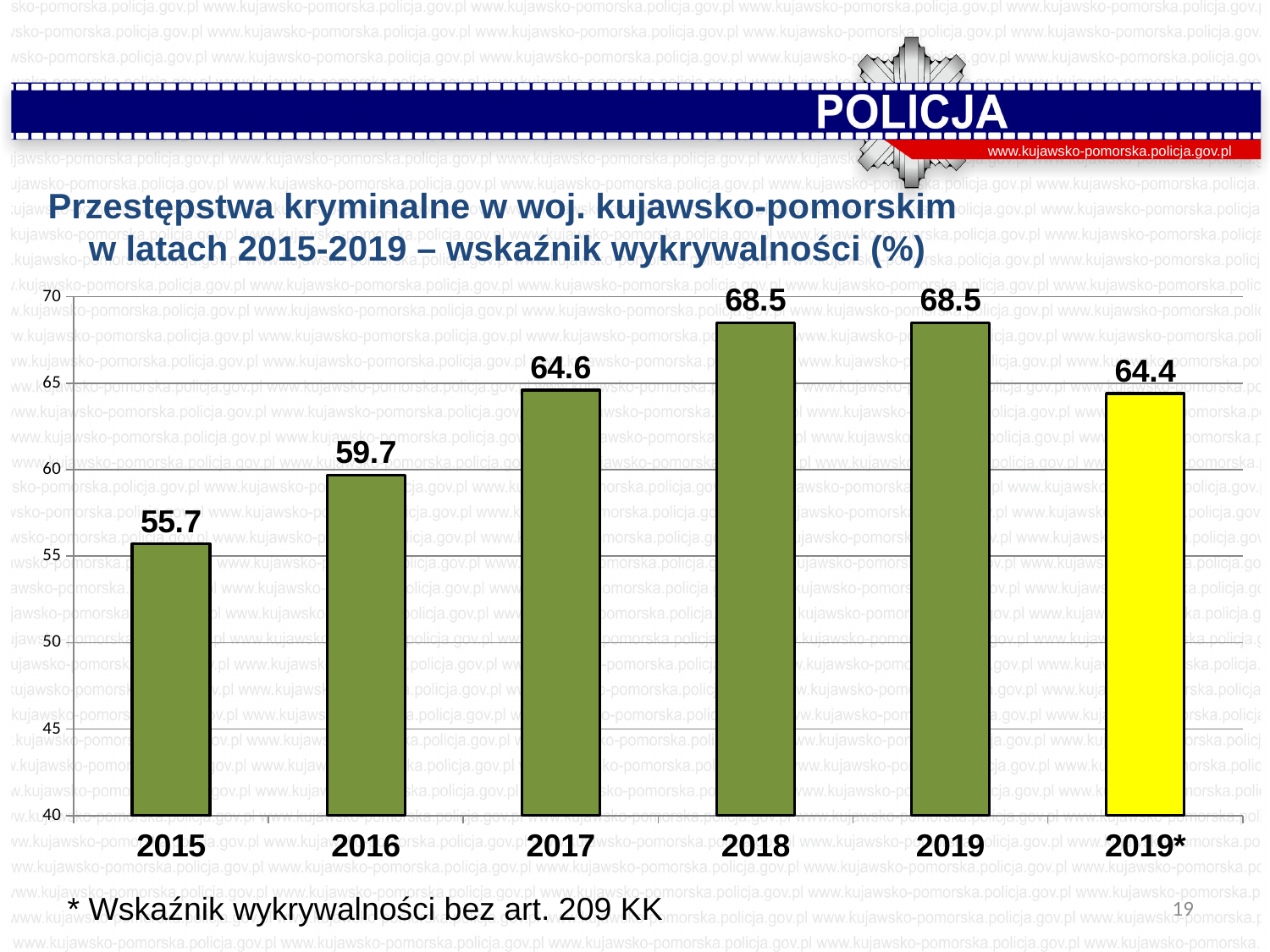
What is the detection rate value shown for 2015? 55.7 What is the difference between the values for 2019 and 2019*? 4.1 What is the value shown for 2017? 64.6 Is the value for 2018 greater or less than 65? greater How many bars are shown on the chart? 6 Which bar is coloured yellow instead of green? 2019* What is the value shown for the 2019* bar? 64.4 What kind of chart is shown on the slide? bar chart What is the difference between the values for 2016 and 2015? 4.0 Do the values rise or fall from 2015 to 2018? rise Which is larger, the value for 2017 or the value for 2019*? 2017 Which year has the lowest value on the chart? 2015